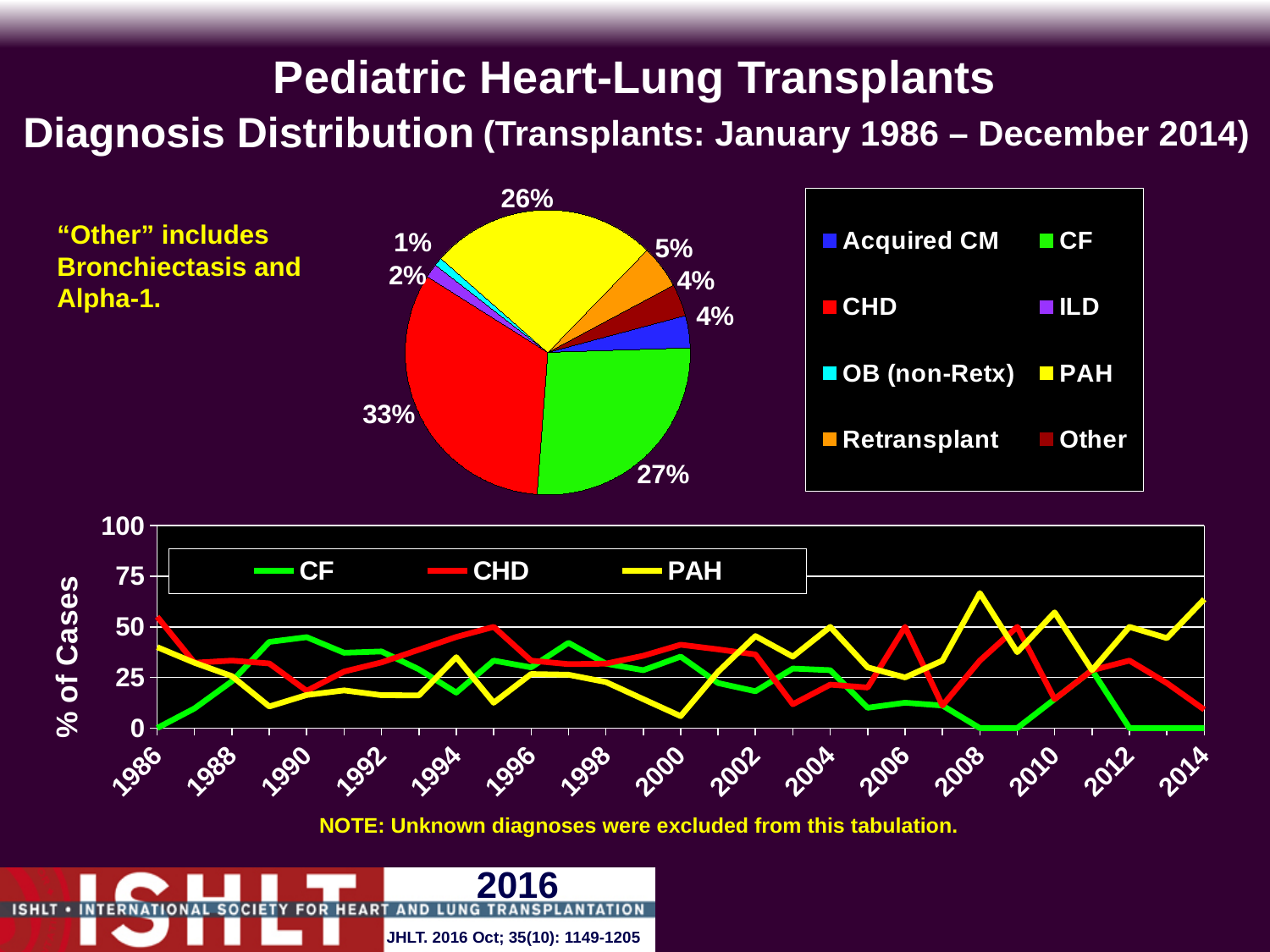
In the pie chart, what percentage is shown for CF? 27% In the pie chart, what percentage is shown for PAH? 26% How many diagnosis categories does the pie chart legend list? 8 In the pie chart, which diagnosis has the largest share? CHD In the line chart at the bottom of the slide, is the value for CHD in 1986 greater or less than 50? greater In the pie chart, which diagnosis has the smallest share? OB (non-Retx) In the pie chart, what share of pediatric heart-lung transplants is attributed to CHD? 33% In the pie chart, what is the difference in percentage points between the CHD share and the PAH share? 7 What type of chart is the chart at the bottom of the slide? Line chart In the pie chart, which has a larger share, Retransplant or ILD? Retransplant How many series does the legend of the line chart at the bottom of the slide list? 3 In the line chart at the bottom of the slide, is the value for PAH in 2014 greater or less than 50? greater